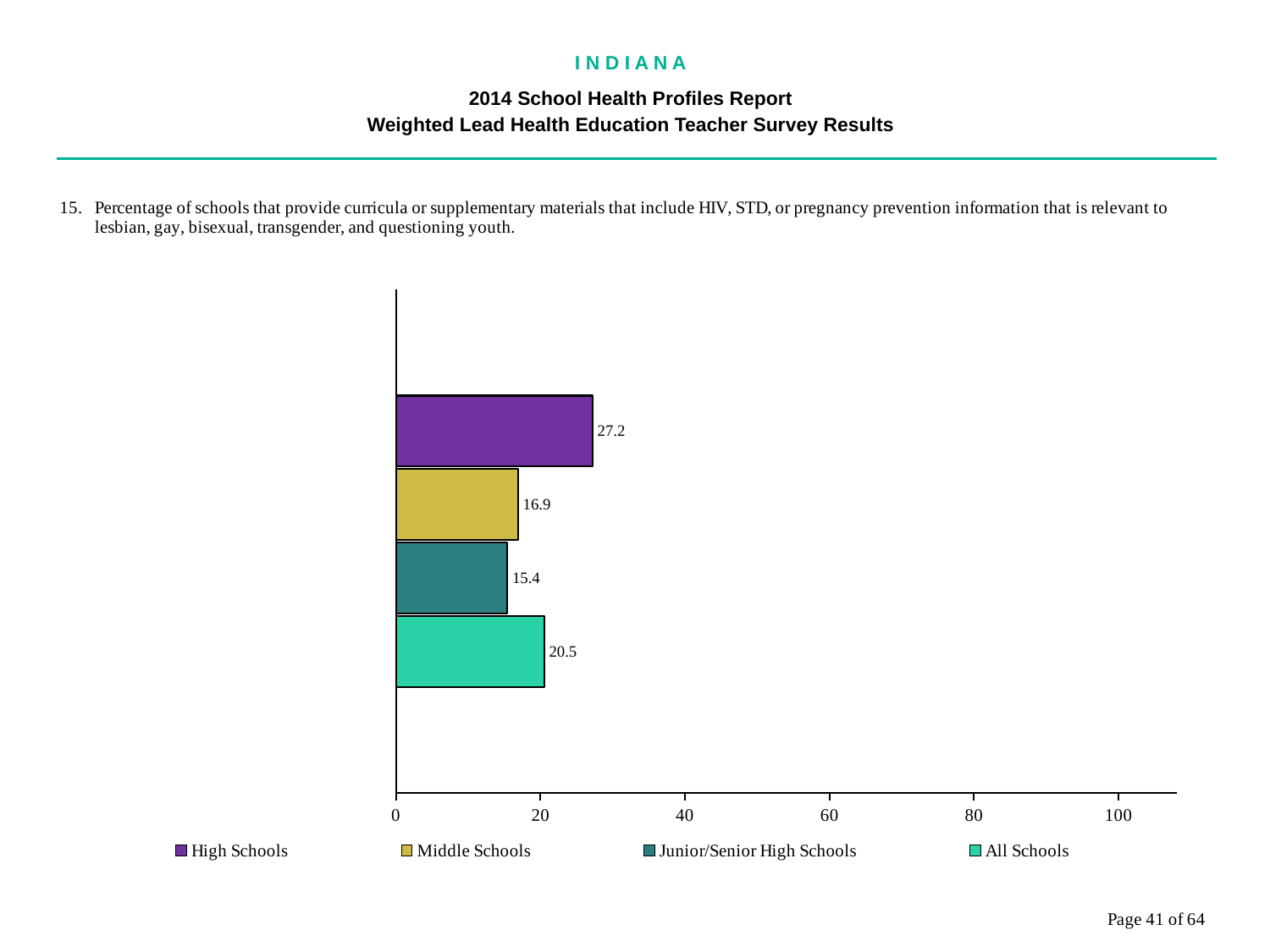
What is the value for Middle Schools? 16.9 How many series does the legend list? 4 What kind of chart is shown on the slide? bar chart What is the difference between the values for High Schools and Middle Schools? 10.3 What is the value for High Schools? 27.2 Is the value for High Schools greater or less than 20? greater What is the difference between the values for All Schools and Junior/Senior High Schools? 5.1 What is the value for Junior/Senior High Schools? 15.4 Which school type has the lowest value? Junior/Senior High Schools Which school type has the highest value? High Schools What is the value for All Schools? 20.5 Which is larger, the value for Middle Schools or the value for All Schools? All Schools